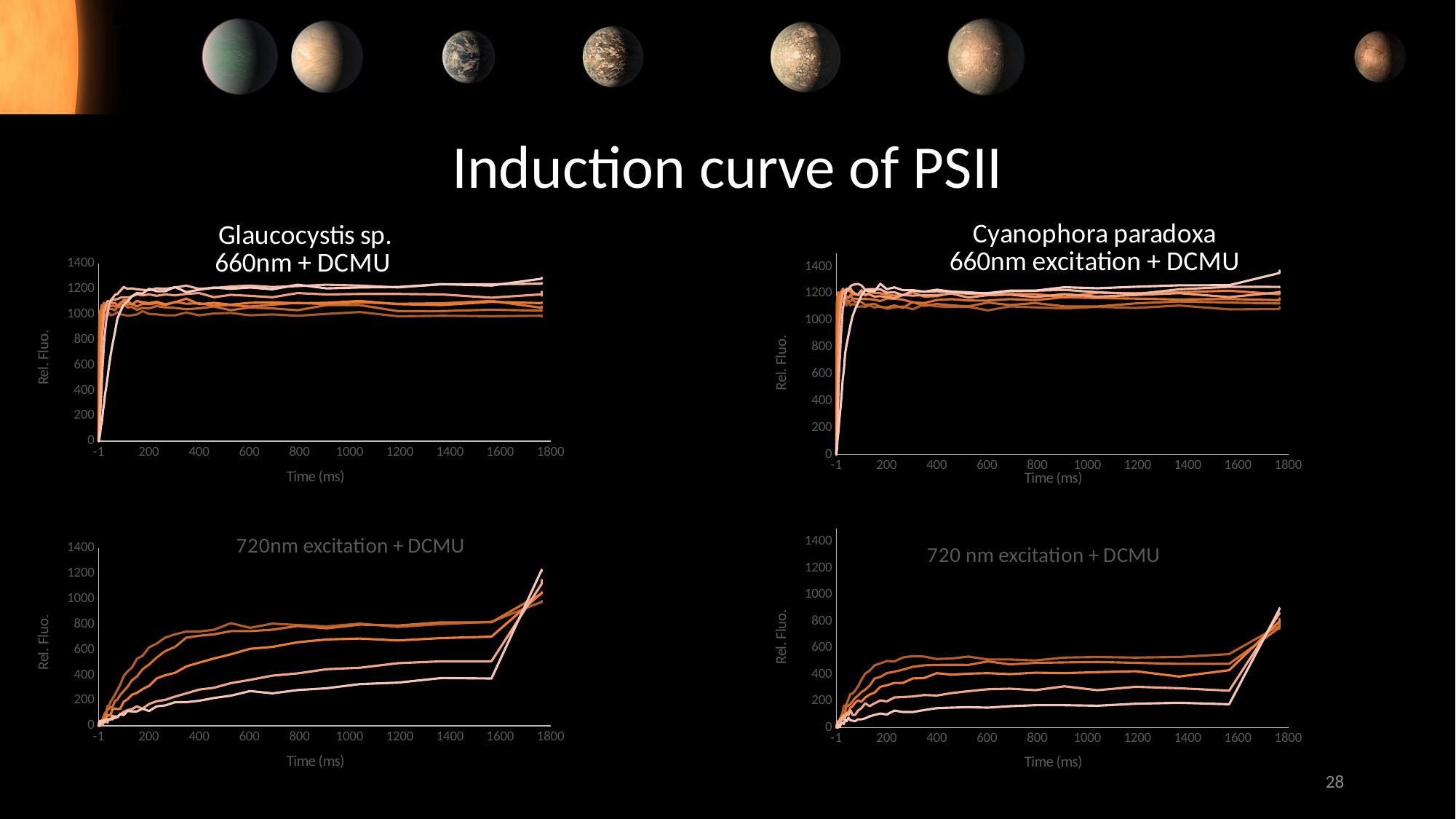
What kind of chart is the top-left chart titled 'Glaucocystis sp. 660nm + DCMU'? line chart In the top-left chart (Glaucocystis sp. 660nm + DCMU), do the lines rise or fall between 0 ms and 100 ms? rise In the bottom-left chart (720nm excitation + DCMU), do the lines rise or fall between 1600 ms and 1800 ms? rise In the bottom-right chart (720 nm excitation + DCMU), do the lines generally rise or fall from 0 ms to 1800 ms? rise In the bottom-left chart (720nm excitation + DCMU), is the value of the lowest line at 1400 ms greater or less than 600? less What is the title of the top-right chart? Cyanophora paradoxa 660nm excitation + DCMU In the bottom-left chart (720nm excitation + DCMU), is the value of the highest line at 600 ms greater or less than 600? greater In the top-right chart (Cyanophora paradoxa 660nm excitation + DCMU), are the line values at 1000 ms greater or less than 800? greater What is the x-axis label on the bottom-left chart (720nm excitation + DCMU)? Time (ms) What is the highest tick value shown on the y axis of the top-left chart (Glaucocystis sp. 660nm + DCMU)? 1400